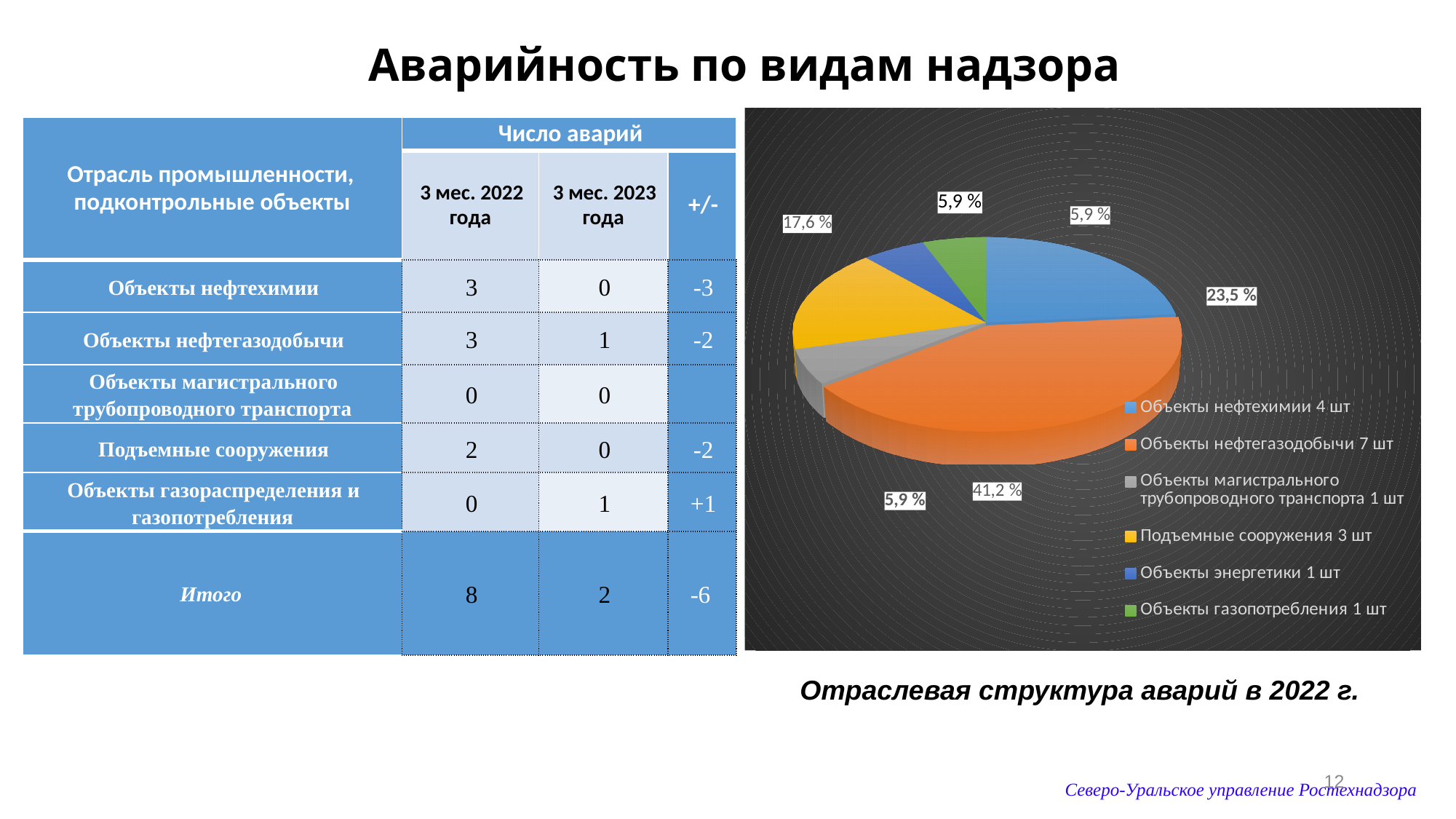
What is the title of the pie chart? Отраслевая структура аварий в 2022 г. How many accidents (шт) does the legend give for Объекты нефтехимии? 4 шт What is the difference in percentage points between the Объекты нефтегазодобычи slice and the Объекты нефтехимии slice? 17,7 % Which category has the largest slice of the pie? Объекты нефтегазодобычи How many accidents (шт) does the legend give for Подъемные сооружения? 3 шт What share of the pie does Объекты нефтехимии have? 23,5 % What share of the pie does Подъемные сооружения have? 17,6 % What share of the pie does Объекты энергетики have? 5,9 % What type of chart is shown on the slide? pie chart How many categories does the pie chart's legend list? 6 Which slice is larger: Объекты нефтехимии or Подъемные сооружения? Объекты нефтехимии